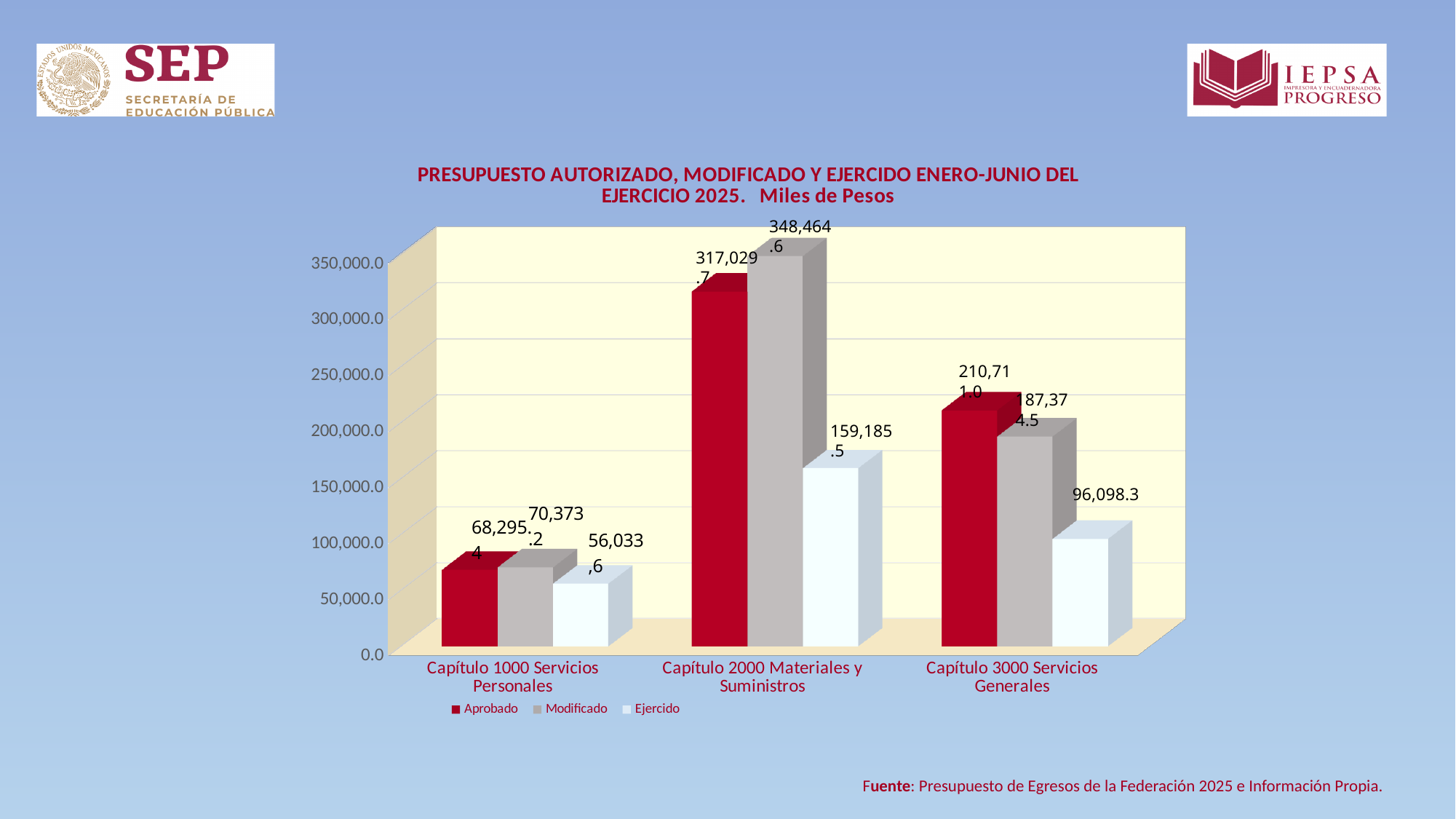
Which series is shown in dark red in the legend? Aprobado What is the Aprobado value for Capítulo 2000 Materiales y Suministros? 317,029.7 What is the Ejercido value for Capítulo 1000 Servicios Personales? 56,033.6 Which category has the highest Modificado value? Capítulo 2000 Materiales y Suministros How many categories are shown on the x axis? 3 What is the difference between the Modificado and Ejercido values for Capítulo 2000 Materiales y Suministros? 189,279.1 Which category has the lowest Ejercido value? Capítulo 1000 Servicios Personales For Capítulo 3000 Servicios Generales, which is larger, the Aprobado value or the Modificado value? Aprobado What is the Modificado value for Capítulo 2000 Materiales y Suministros? 348,464.6 What is the Ejercido value for Capítulo 3000 Servicios Generales? 96,098.3 What type of chart is shown on the slide? bar chart How many series does the legend list? 3